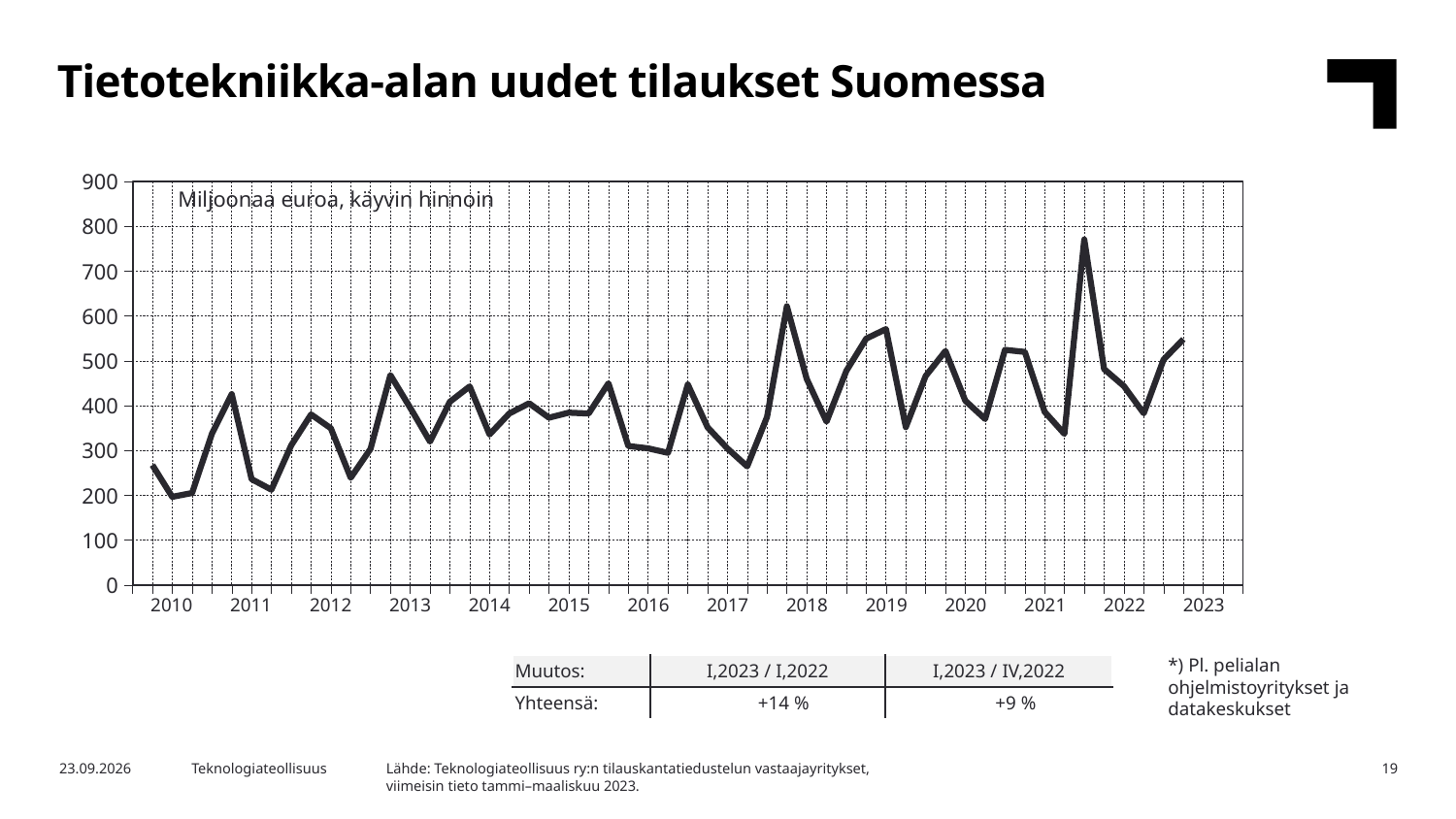
What unit is stated inside the chart area? Miljoonaa euroa, käyvin hinnoin Is the lowest point of the line in 2017 greater or less than 300? less Is the peak of the line in 2018 greater or less than 500? greater Is the highest peak of the line, in 2021, greater or less than 700? greater How many year labels are shown on the x axis? 14 Which is higher: the peak in 2018 or the peak in 2021? the peak in 2021 What is the title of the chart on the slide? Tietotekniikka-alan uudet tilaukset Suomessa Which is higher: the first value in 2010 or the last value in 2023? the last value in 2023 What kind of chart is shown on the slide? line chart In which year does the line reach its highest peak? 2021